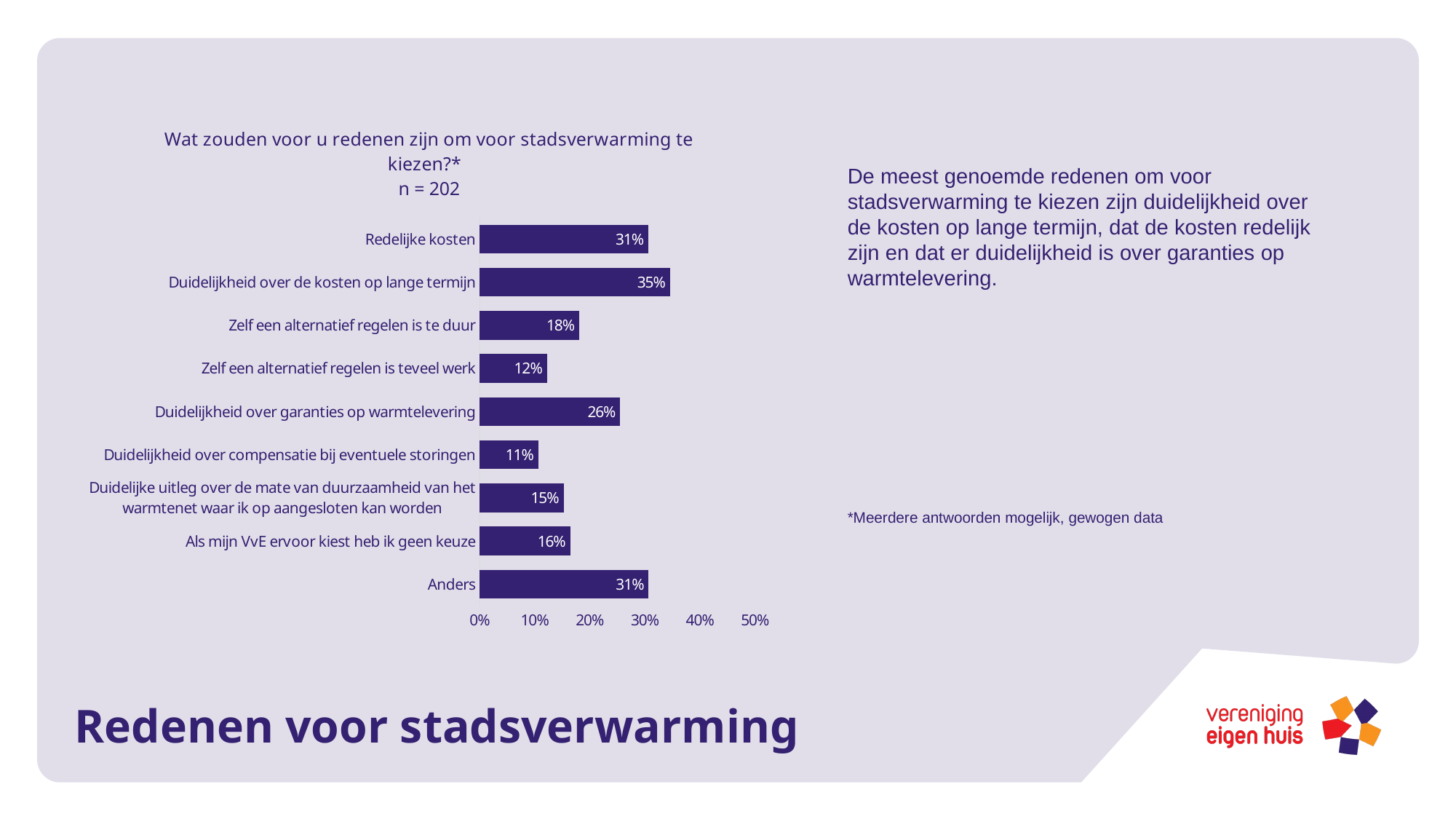
What is the value for 'Duidelijkheid over de kosten op lange termijn'? 35% What kind of chart is shown on the slide? Bar chart Which is larger: 'Zelf een alternatief regelen is te duur' or 'Duidelijkheid over garanties op warmtelevering'? Duidelijkheid over garanties op warmtelevering What is the value for 'Zelf een alternatief regelen is teveel werk'? 12% Is the value for 'Duidelijkheid over garanties op warmtelevering' greater or less than 20%? greater What is the sample size (n) stated in the chart title? 202 Which category has the lowest value? Duidelijkheid over compensatie bij eventuele storingen Which category has the highest value? Duidelijkheid over de kosten op lange termijn What is the highest value shown on the x axis? 50% What is the difference between 'Duidelijkheid over de kosten op lange termijn' and 'Redelijke kosten'? 4% How many categories are shown in the chart? 9 What is the value for 'Als mijn VvE ervoor kiest heb ik geen keuze'? 16%